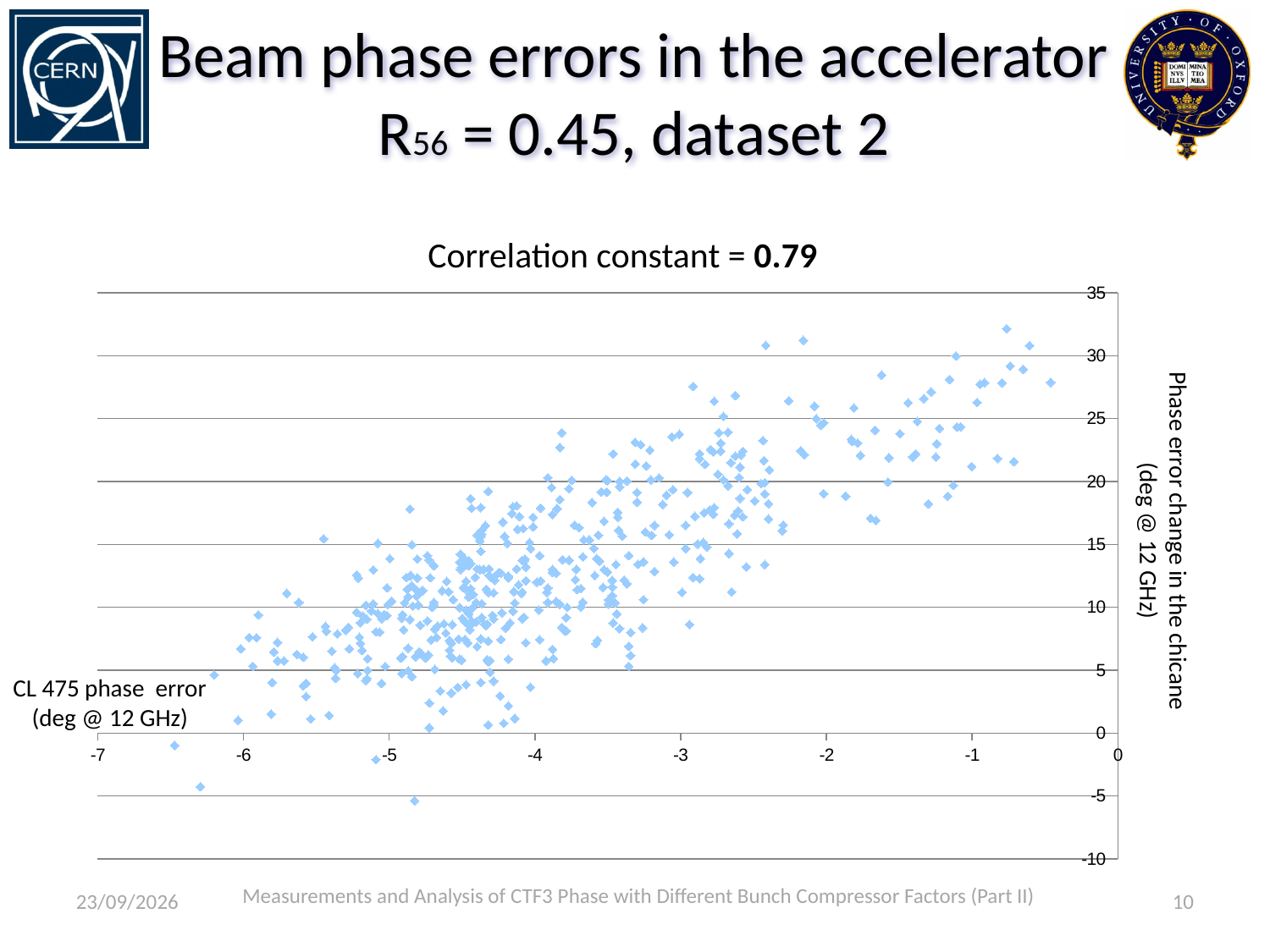
What correlation constant is stated above the chart? 0.79 Do the plotted values of phase error change in the chicane rise or fall as the CL 475 phase error increases along the x axis? rise What kind of chart is shown on the slide? scatter chart What is the label of the vertical axis of the chart? Phase error change in the chicane (deg @ 12 GHz)